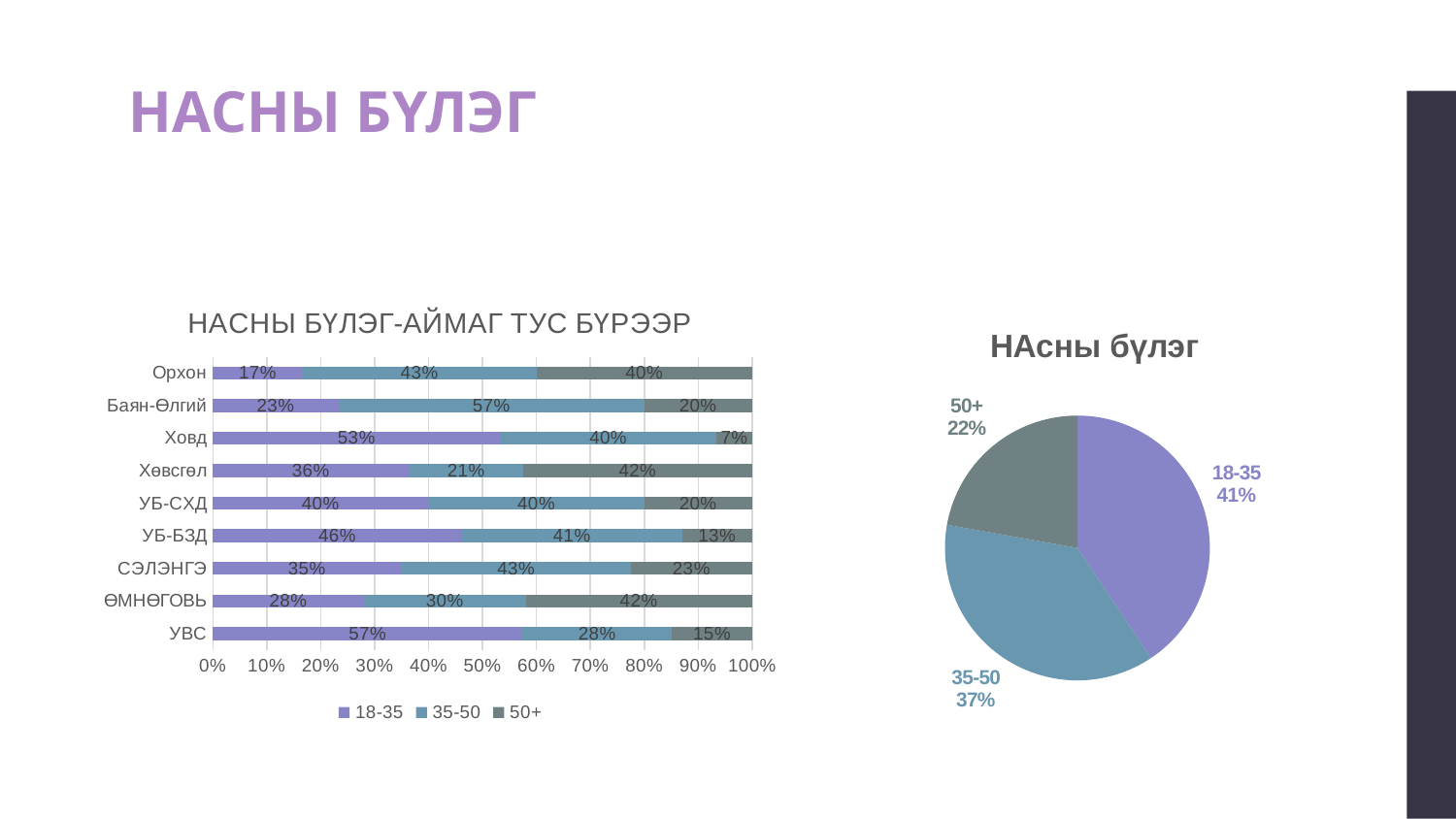
In the pie chart titled НАсны бүлэг, what share does the 35-50 slice have? 37% In the bar chart titled НАСНЫ БҮЛЭГ-АЙМАГ ТУС БҮРЭЭР, which category has the lowest value for the 50+ series? Ховд How many categories are shown in the bar chart titled НАСНЫ БҮЛЭГ-АЙМАГ ТУС БҮРЭЭР? 9 In the bar chart titled НАСНЫ БҮЛЭГ-АЙМАГ ТУС БҮРЭЭР, what is the value of the 35-50 series for Баян-Өлгий? 57% In the pie chart titled НАсны бүлэг, which slice is the largest? 18-35 In the bar chart titled НАСНЫ БҮЛЭГ-АЙМАГ ТУС БҮРЭЭР, what is the value of the 50+ series for Хөвсгөл? 42% In the bar chart titled НАСНЫ БҮЛЭГ-АЙМАГ ТУС БҮРЭЭР, what is the value of the 18-35 series for Ховд? 53% In the bar chart titled НАСНЫ БҮЛЭГ-АЙМАГ ТУС БҮРЭЭР, what is the difference between the 18-35 values for УВС and Орхон? 40% In the bar chart titled НАСНЫ БҮЛЭГ-АЙМАГ ТУС БҮРЭЭР, which is larger: the 35-50 value for Орхон or the 35-50 value for Хөвсгөл? Орхон In the bar chart titled НАСНЫ БҮЛЭГ-АЙМАГ ТУС БҮРЭЭР, which category has the highest value for the 18-35 series? УВС What kind of chart is the chart titled НАСНЫ БҮЛЭГ-АЙМАГ ТУС БҮРЭЭР? Stacked bar chart How many series does the legend of the bar chart titled НАСНЫ БҮЛЭГ-АЙМАГ ТУС БҮРЭЭР list? 3